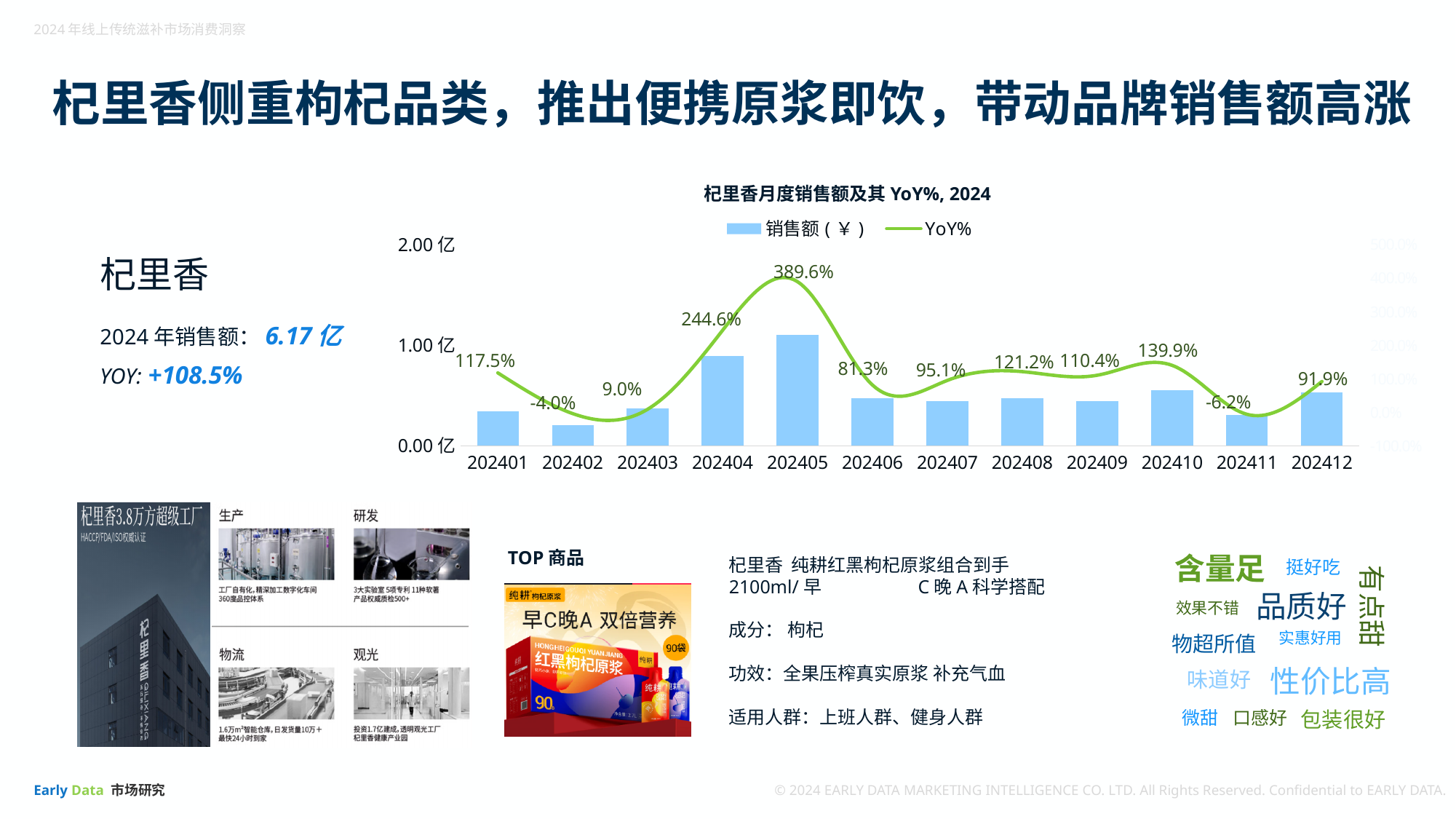
What is the difference between the YoY% values for 202405 and 202404? 145.0% What is the YoY% value for 202402? -4.0% Is the sales (销售额) bar for 202405 greater or less than 1.00 亿? greater Is the sales (销售额) bar for 202401 greater or less than 1.00 亿? less How many series does the chart legend list? 2 Which month has the lowest YoY% value? 202411 Which month has the highest YoY% value? 202405 What is the title of the chart? 杞里香月度销售额及其 YoY%, 2024 Which month has a higher YoY% value, 202408 or 202409? 202408 How many months are shown on the x axis of the chart? 12 What is the YoY% value for 202410? 139.9% What is the YoY% value for 202405? 389.6%